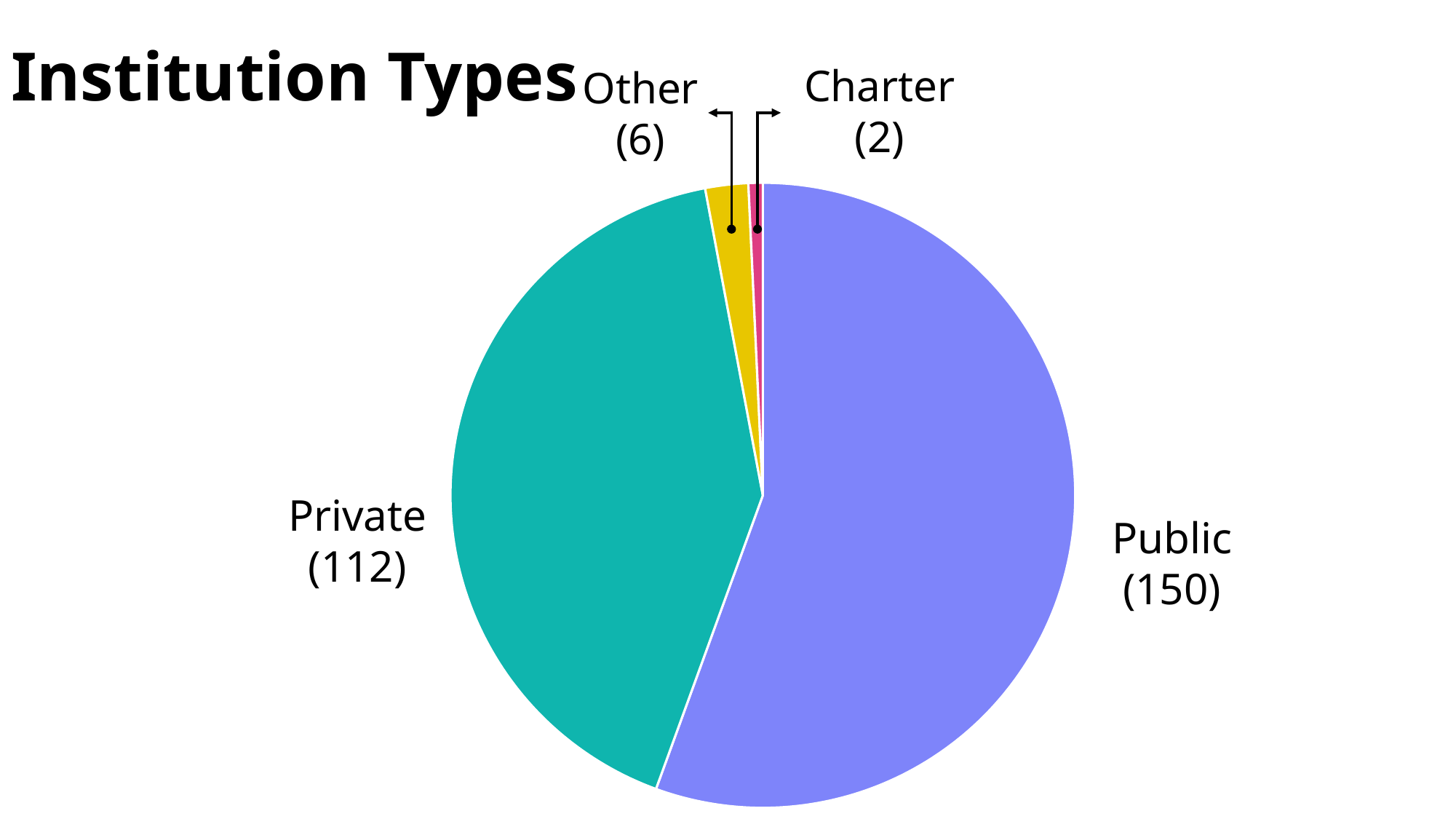
What type of chart is shown on the slide? pie chart What is the title of the chart? Institution Types How many institutions are in the Other category? 6 How many institutions are Public? 150 How many institution types are shown in the pie chart? 4 Which is larger, the Other slice or the Charter slice? Other What is the total number of institutions across all slices? 270 How many institutions are Private? 112 How many institutions are Charter? 2 Which institution type has the smallest slice? Charter Which institution type has the largest slice? Public What is the difference between the number of Public and Private institutions? 38